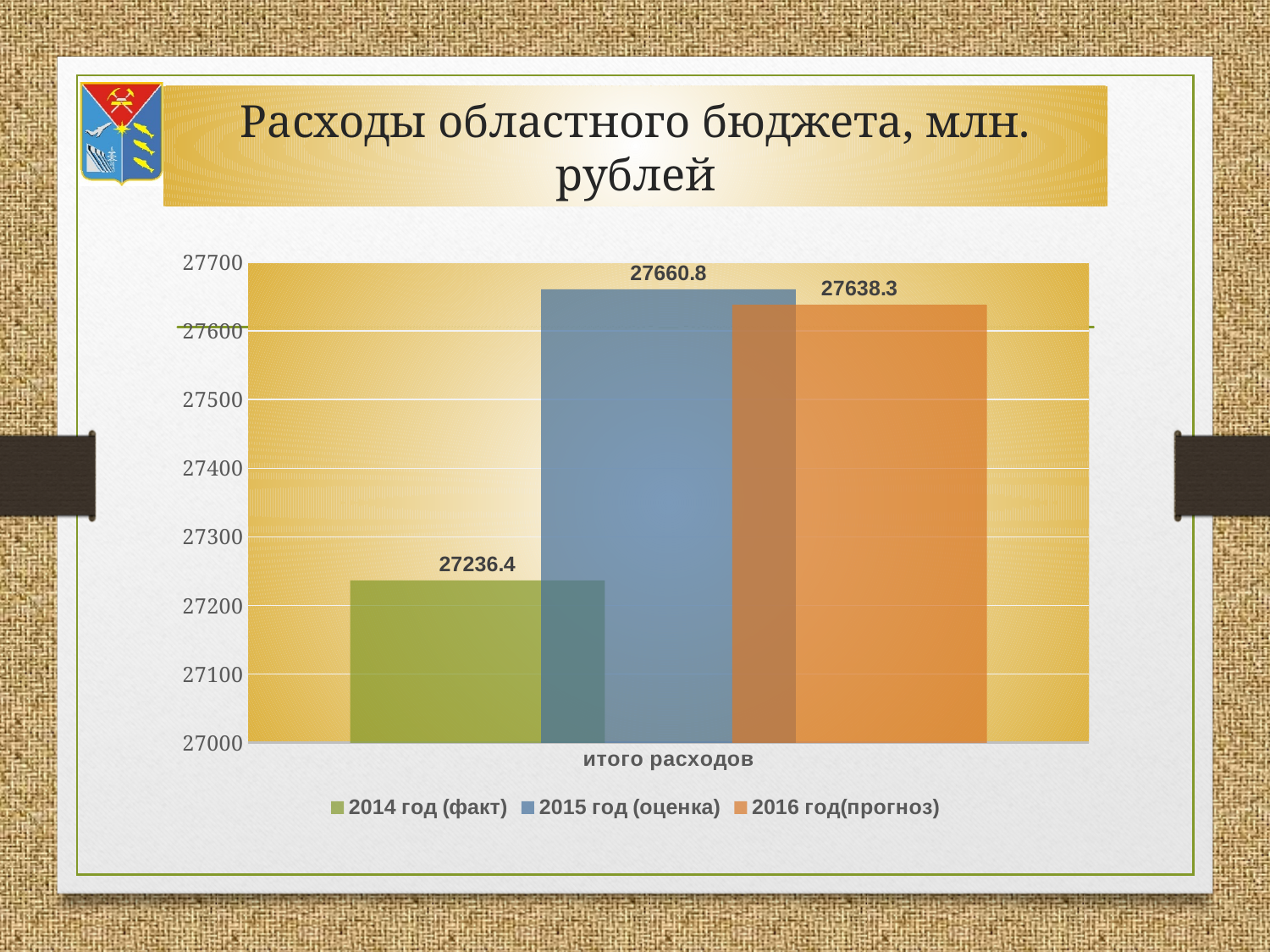
Which series has the lowest value in the chart? 2014 год (факт) What is the value for 2016 год(прогноз) in the chart? 27638.3 Which series has the highest value in the chart? 2015 год (оценка) What is the value for 2015 год (оценка) in the chart? 27660.8 What kind of chart is shown on the slide? bar chart What is the title of the chart on the slide? Расходы областного бюджета, млн. рублей What is the difference between the 2015 год (оценка) value and the 2014 год (факт) value? 424.4 What is the difference between the 2015 год (оценка) value and the 2016 год(прогноз) value? 22.5 What is the value for 2014 год (факт) in the chart? 27236.4 Which is larger, the value for 2016 год(прогноз) or the value for 2014 год (факт)? 2016 год(прогноз) Is the value for 2014 год (факт) greater or less than 27300? less How many series does the legend list? 3